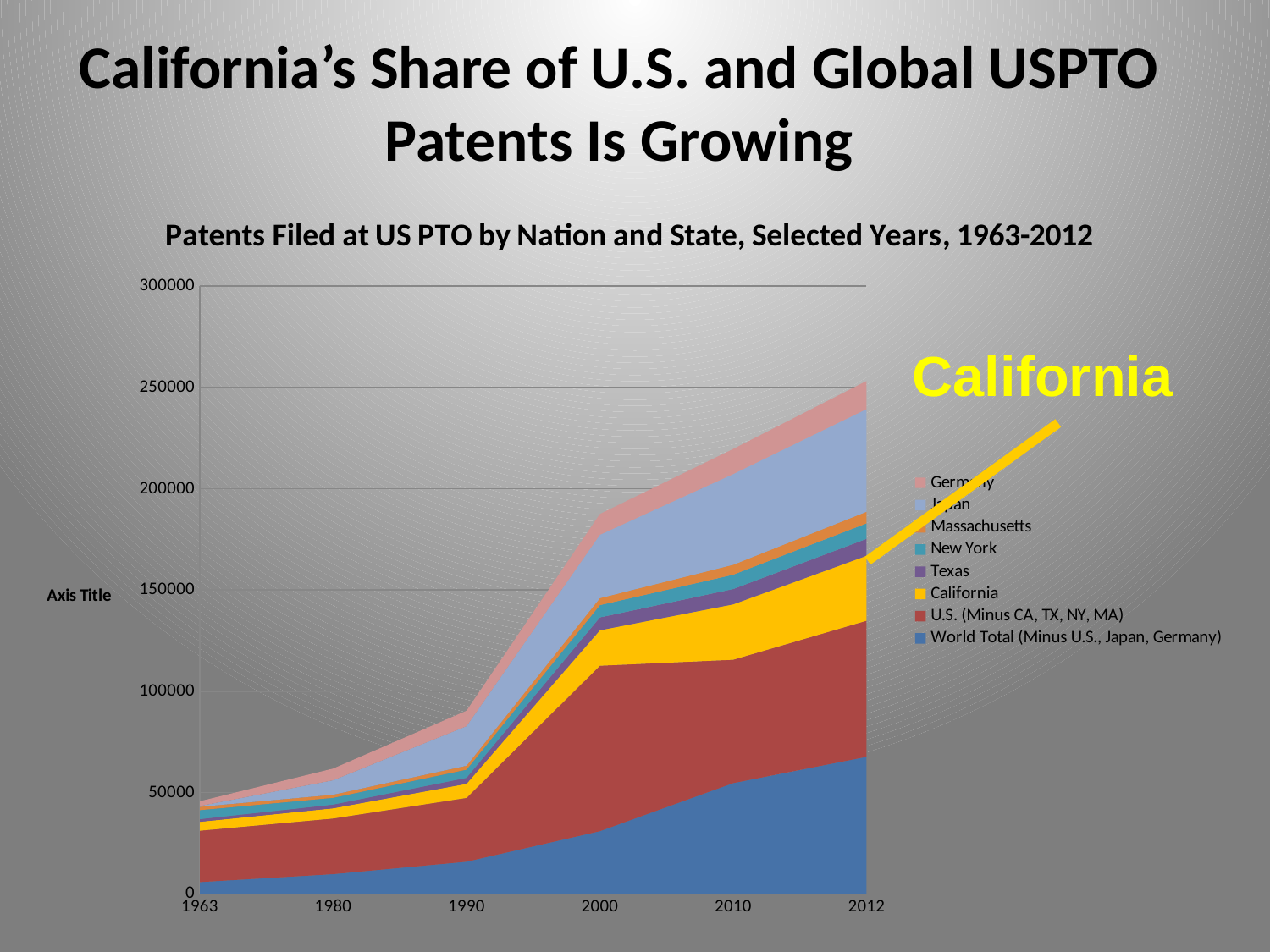
Is the total stacked value for 1990 greater or less than 100000? less Is the total stacked value for 1963 greater or less than 50000? less How many years are shown along the x axis of the chart? 6 Is the total stacked value for 2000 greater or less than 150000? greater What kind of chart is shown on the slide? Stacked area chart Which series is shown at the bottom of the stacked area chart? World Total (Minus U.S., Japan, Germany) Does the total stacked value rise or fall from 1963 to 2012? Rise What is the title of the chart? Patents Filed at US PTO by Nation and State, Selected Years, 1963-2012 In which year is the total stacked value highest? 2012 How many series does the chart's legend list? 8 In which year is the total stacked value lowest? 1963